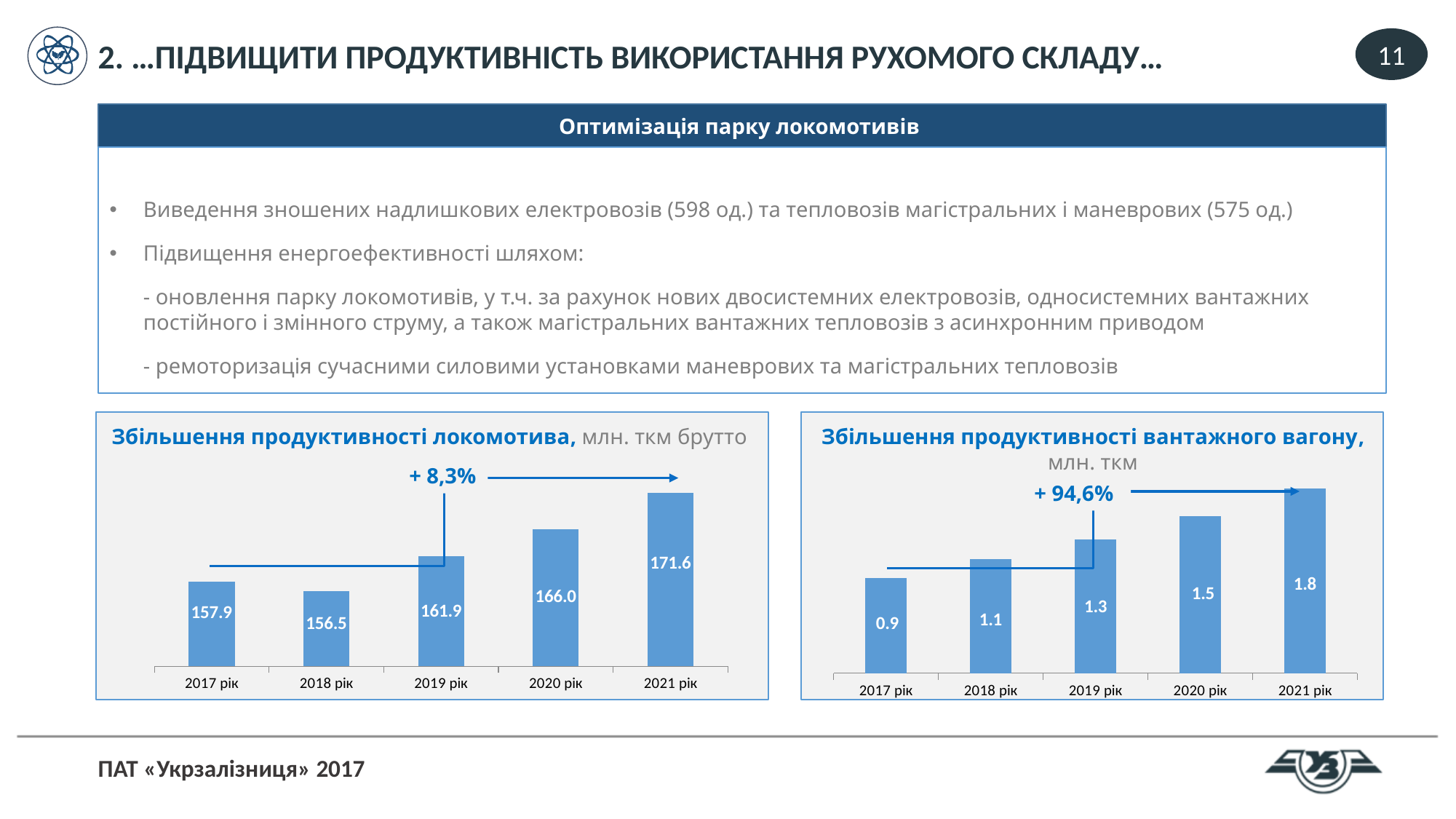
In the right chart (Збільшення продуктивності вантажного вагону), do the values rise or fall from 2017 рік to 2021 рік? rise What type of chart is the right chart (Збільшення продуктивності вантажного вагону)? bar chart In the left chart (Збільшення продуктивності локомотива), which is larger, the value for 2017 рік or 2018 рік? 2017 рік In the right chart (Збільшення продуктивності вантажного вагону), which year has the highest value? 2021 рік In the left chart (Збільшення продуктивності локомотива), what is the value for 2021 рік? 171.6 In the right chart (Збільшення продуктивності вантажного вагону), what is the value for 2017 рік? 0.9 In the right chart (Збільшення продуктивності вантажного вагону), what is the value for 2020 рік? 1.5 In the left chart (Збільшення продуктивності локомотива), what is the difference between the 2021 рік and 2017 рік values? 13.7 In the right chart (Збільшення продуктивності вантажного вагону), what is the difference between the 2021 рік and 2019 рік values? 0.5 In the left chart (Збільшення продуктивності локомотива), which year has the lowest value? 2018 рік In the left chart (Збільшення продуктивності локомотива), how many years are shown on the x axis? 5 In the left chart (Збільшення продуктивності локомотива), what is the value for 2019 рік? 161.9